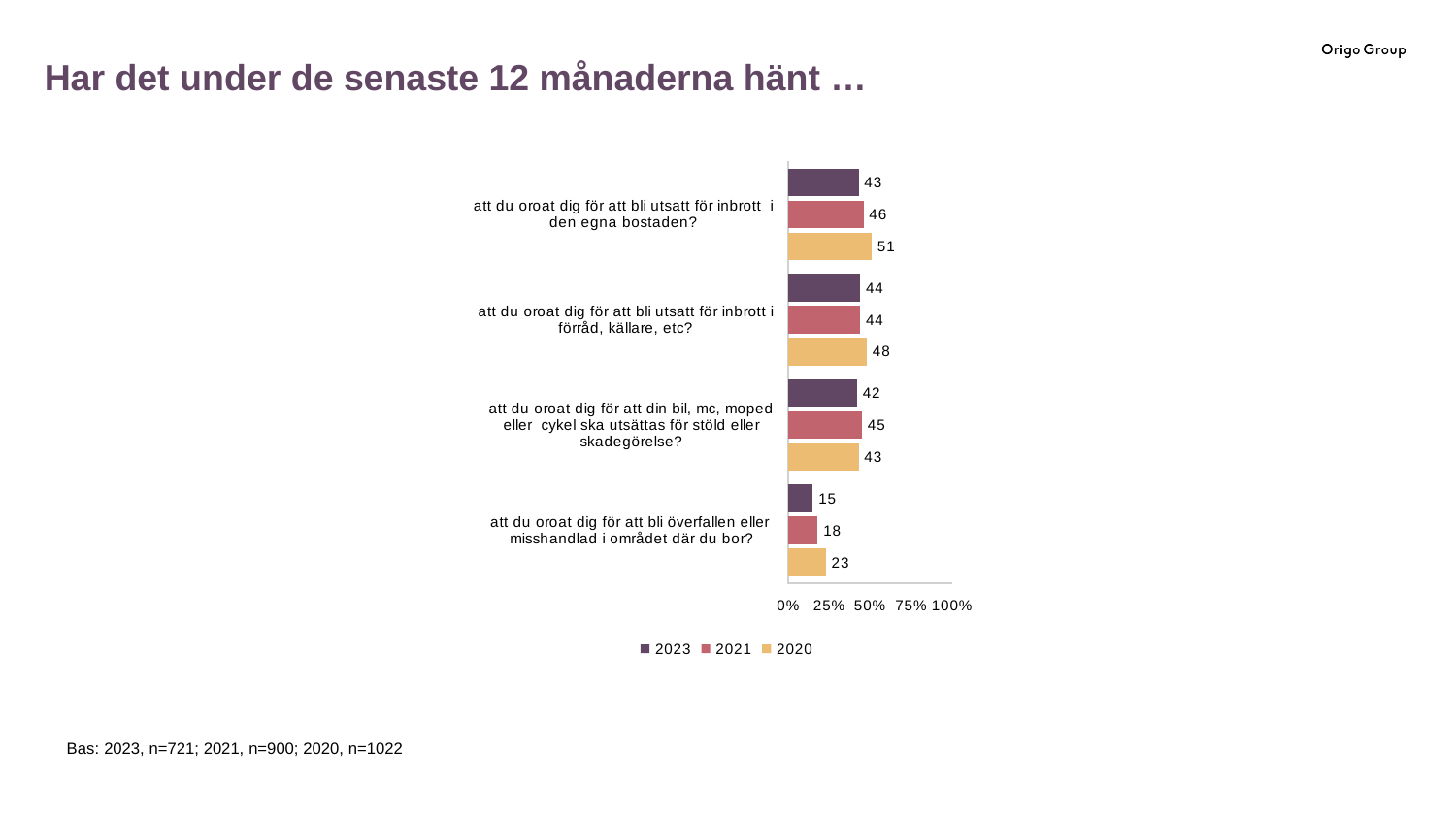
How many series does the legend list? 3 What is the 2020 value for 'att du oroat dig för att bli överfallen eller misshandlad i området där du bor?' 23 What kind of chart is shown on the slide? bar chart Which category has the lowest 2023 value? att du oroat dig för att bli överfallen eller misshandlad i området där du bor? For 'att du oroat dig för att bli överfallen eller misshandlad i området där du bor?', which year has the larger value, 2021 or 2023? 2021 What is the 2020 value for 'att du oroat dig för att bli utsatt för inbrott i förråd, källare, etc?' 48 What is the 2023 value for 'att du oroat dig för att bli utsatt för inbrott i den egna bostaden?' 43 How many categories are shown on the chart? 4 Is the 2020 value for 'att du oroat dig för att bli utsatt för inbrott i den egna bostaden?' greater or less than 25%? greater What is the 2021 value for 'att du oroat dig för att din bil, mc, moped eller cykel ska utsättas för stöld eller skadegörelse?' 45 What is the difference between the 2020 and 2023 values for 'att du oroat dig för att bli utsatt för inbrott i den egna bostaden?' 8 Which category has the highest 2020 value? att du oroat dig för att bli utsatt för inbrott i den egna bostaden?